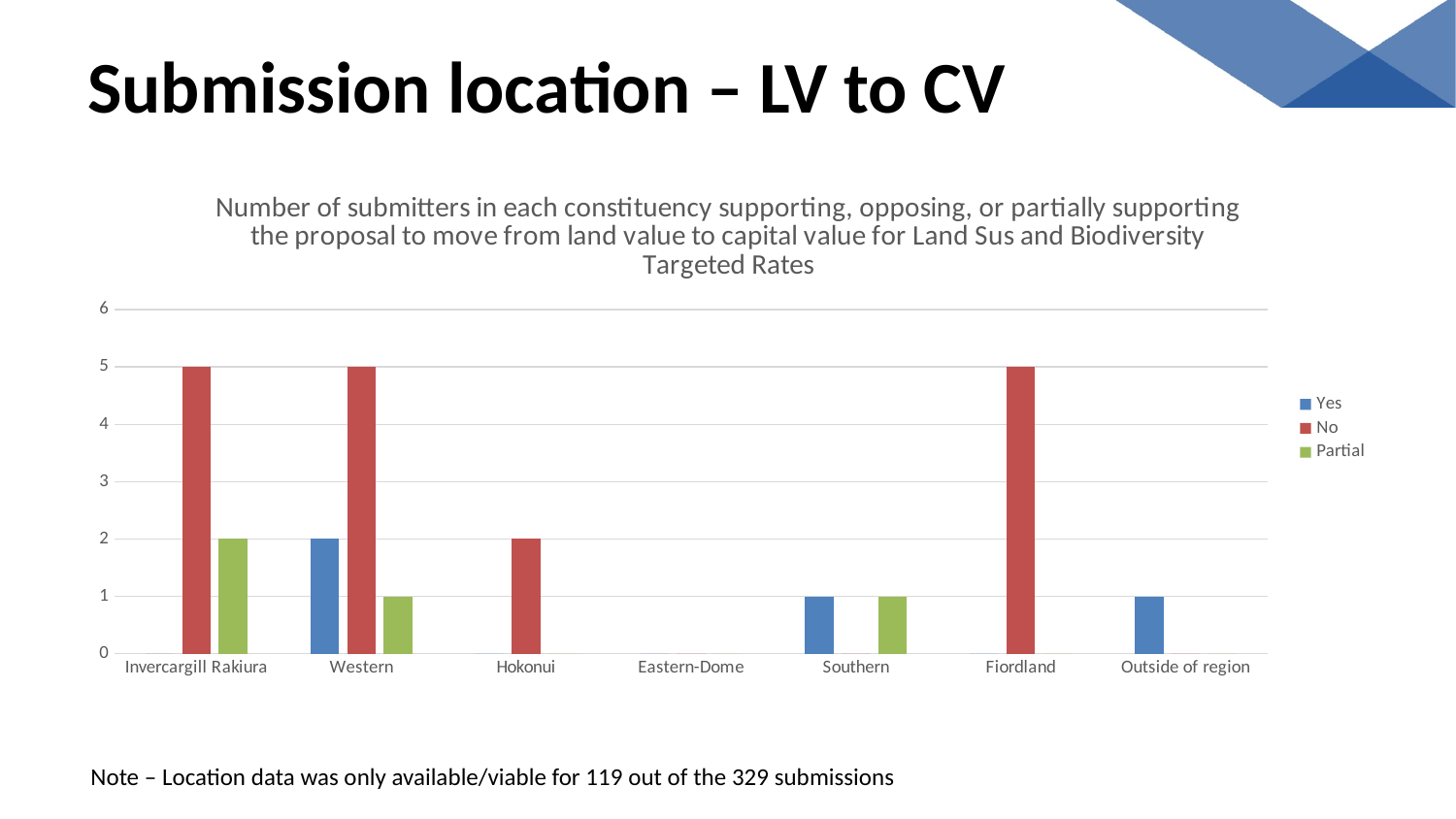
What is the value of the No series for Western? 5 Which is larger, the No value for Hokonui or the No value for Fiordland? Fiordland What is the value of the Partial series for Invercargill Rakiura? 2 What kind of chart is shown on the slide? Bar chart What is the difference between the No value and the Yes value for Western? 3 What is the value of the No series for Hokonui? 2 Which constituency has the highest Yes value? Western Is the No value for Invercargill Rakiura greater or less than 3? greater What is the value of the Yes series for Outside of region? 1 How many constituency categories are shown on the x axis? 7 Which series is shown in red in the legend? No How many series does the legend list? 3